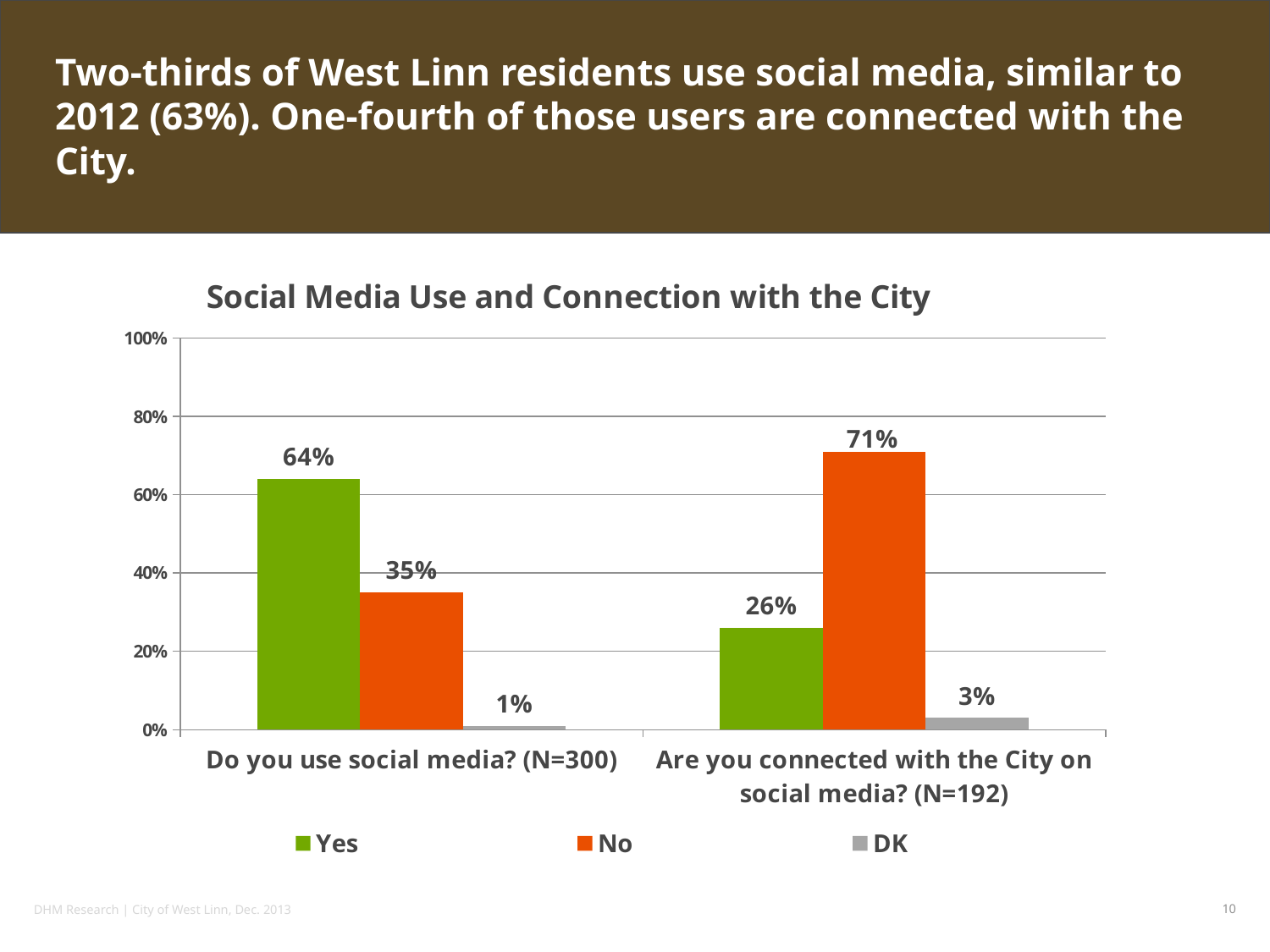
How many series does the legend list? 3 What is the "DK" value for "Do you use social media? (N=300)"? 1% What kind of chart is shown on the slide? Bar chart What percentage answered "Yes" to "Do you use social media? (N=300)"? 64% Which response has the lowest value for "Do you use social media? (N=300)"? DK What percentage answered "No" to "Are you connected with the City on social media? (N=192)"? 71% Which is larger: the "No" value for "Do you use social media? (N=300)" or the "Yes" value for "Are you connected with the City on social media? (N=192)"? No for "Do you use social media? (N=300)" What is the difference between the "Yes" and "No" values for "Do you use social media? (N=300)"? 29% What is the "Yes" value for "Are you connected with the City on social media? (N=192)"? 26% Which response has the highest value for "Are you connected with the City on social media? (N=192)"? No How many question categories are shown on the x axis? 2 What is the title of the chart? Social Media Use and Connection with the City